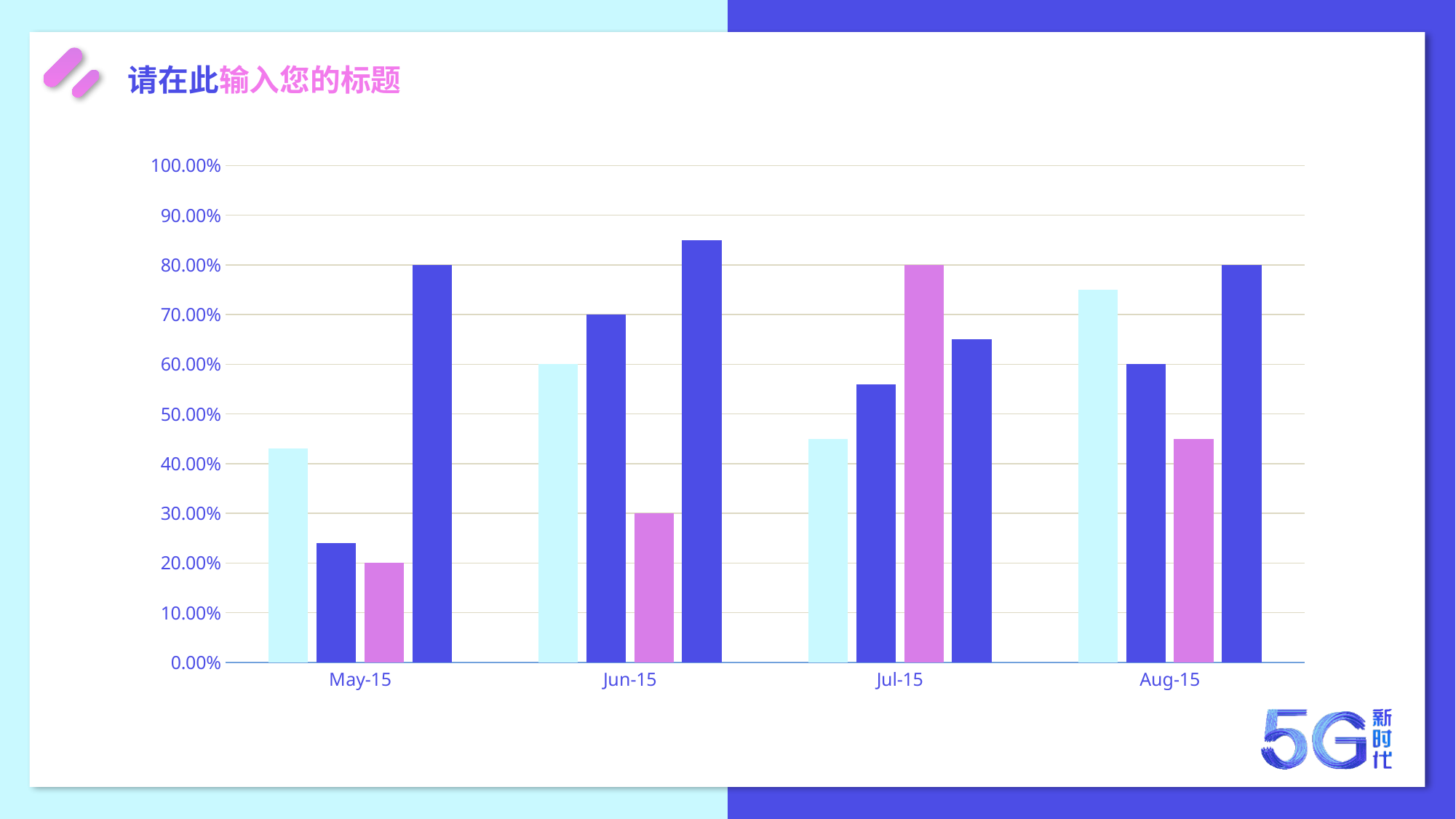
What is the highest value shown on the y axis of the chart? 100.00% Is the value of the light cyan (first) bar for Aug-15 greater or less than 70.00%? greater Is the value of the light cyan (first) bar for Jul-15 greater or less than 50.00%? less Which is larger: the pink (third) bar for Jun-15 or the pink (third) bar for Aug-15? Aug-15 Which category on the x axis contains the tallest bar in the chart? Jun-15 What is the value of the light cyan (first) bar for Jun-15? 60.00% How many categories are shown on the x axis of the chart? 4 What kind of chart is shown on the slide? bar chart Is the value of the light cyan (first) bar for May-15 greater or less than 40.00%? greater Which category on the x axis contains the shortest bar in the chart? May-15 What is the value of the pink (third) bar for Jul-15? 80.00% What is the value of the pink (third) bar for Jun-15? 30.00%